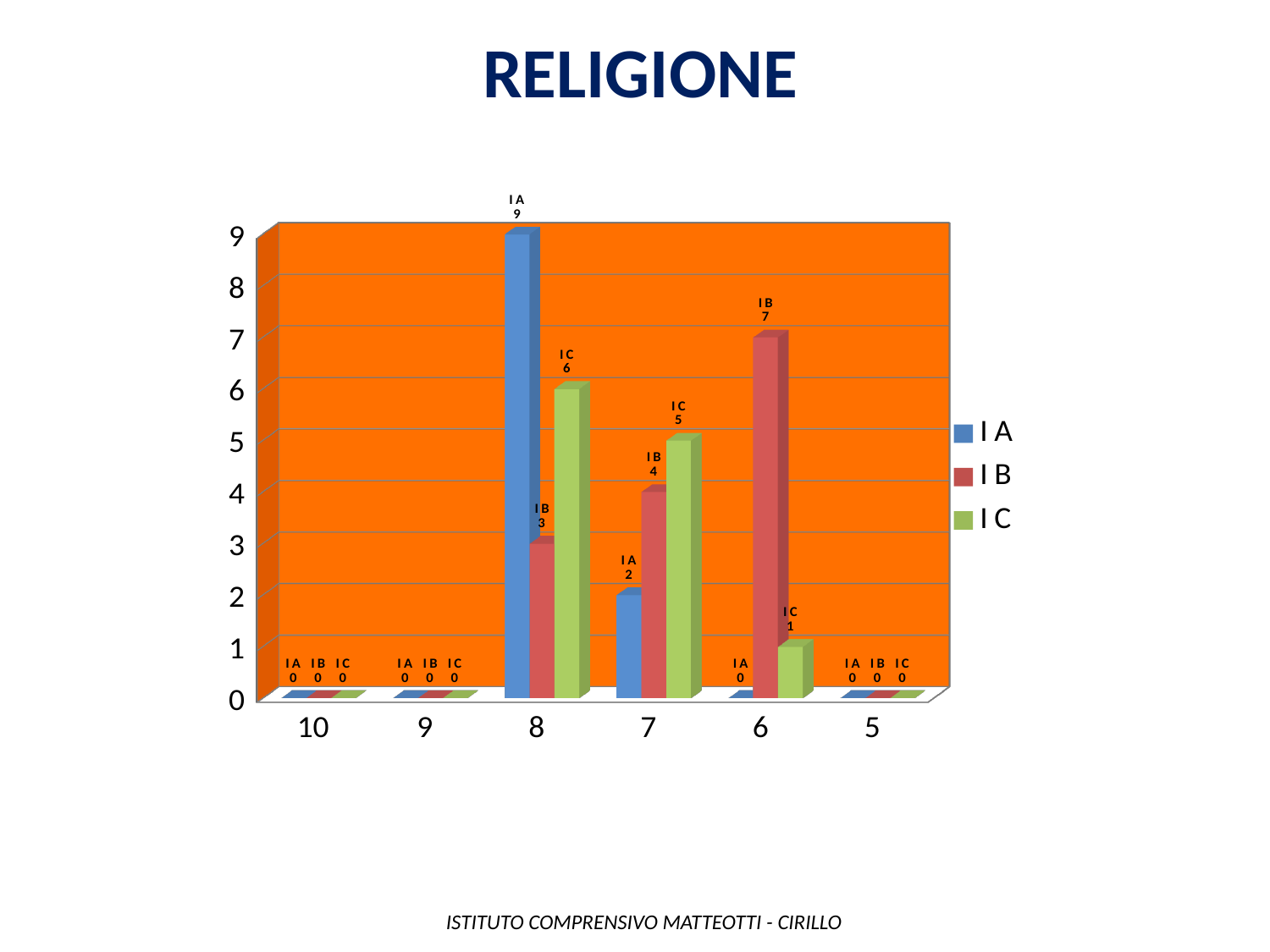
What is the difference between I A and I B at category 8? 6 What is the value for I A at category 8? 9 Which is larger at category 7: I B or I C? I C What is the value for I B at category 6? 7 What is the title of the chart? RELIGIONE Which category has the highest value for I C? 8 Which category has the highest value for I B? 6 What is the value for I C at category 7? 5 What kind of chart is shown on the slide? bar chart How many categories are shown on the x axis? 6 What is the value for I A at category 7? 2 How many series does the legend list? 3